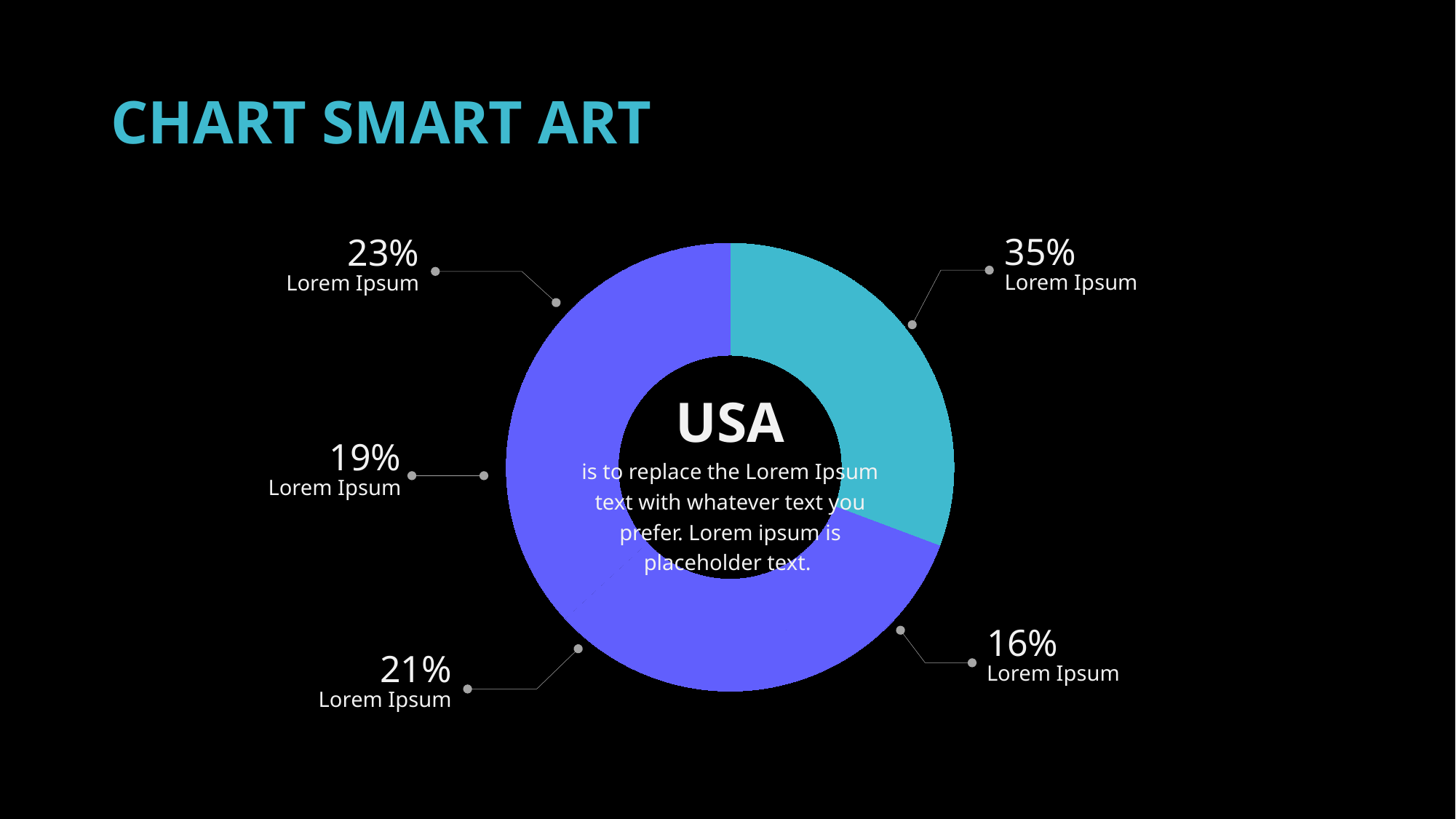
What is the title of the slide? CHART SMART ART What is the lowest percentage labelled on the chart? 16% What percentage is labelled for the teal (light blue) slice of the chart? 35% What is the highest percentage labelled on the chart? 35% What percentage is labelled at the bottom-left of the chart? 21% Which is larger, the value labelled at the top-left (23%) or the value labelled at the bottom-left (21%)? 23% What word is written in large bold text in the centre of the donut chart? USA What percentage is labelled at the bottom-right of the chart? 16% What is the difference between the largest labelled value (35%) and the smallest labelled value (16%)? 19% What kind of chart is shown on the slide? pie chart (donut) How many percentage values are labelled around the chart? 5 What percentage is labelled at the top-left of the chart? 23%